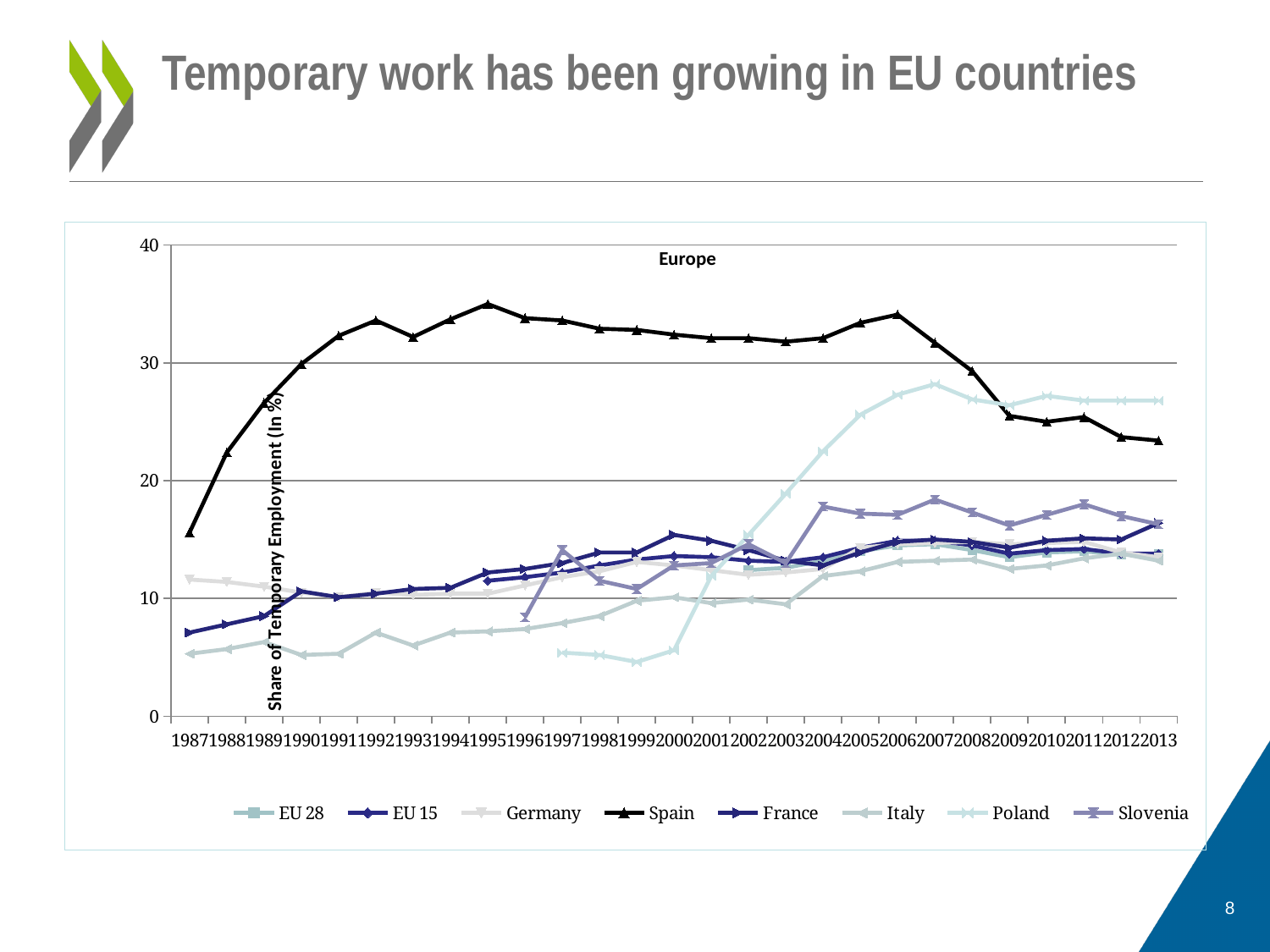
Is the value for Spain in 1995 greater or less than 30? greater Is the value for Spain in 1987 greater or less than 20? less Does the value for Poland rise or fall between 1999 and 2007? rise Is the value for Poland in 1999 greater or less than 10? less How many series does the legend list? 8 How many years are shown along the x axis? 27 In 2013, which is larger, the value for Poland or the value for Spain? Poland Which series has the lowest value in 1987? Italy What is the label on the y axis of the chart? Share of Temporary Employment (in %) Which series has the highest value in 1995? Spain What kind of chart is shown on the slide? line chart